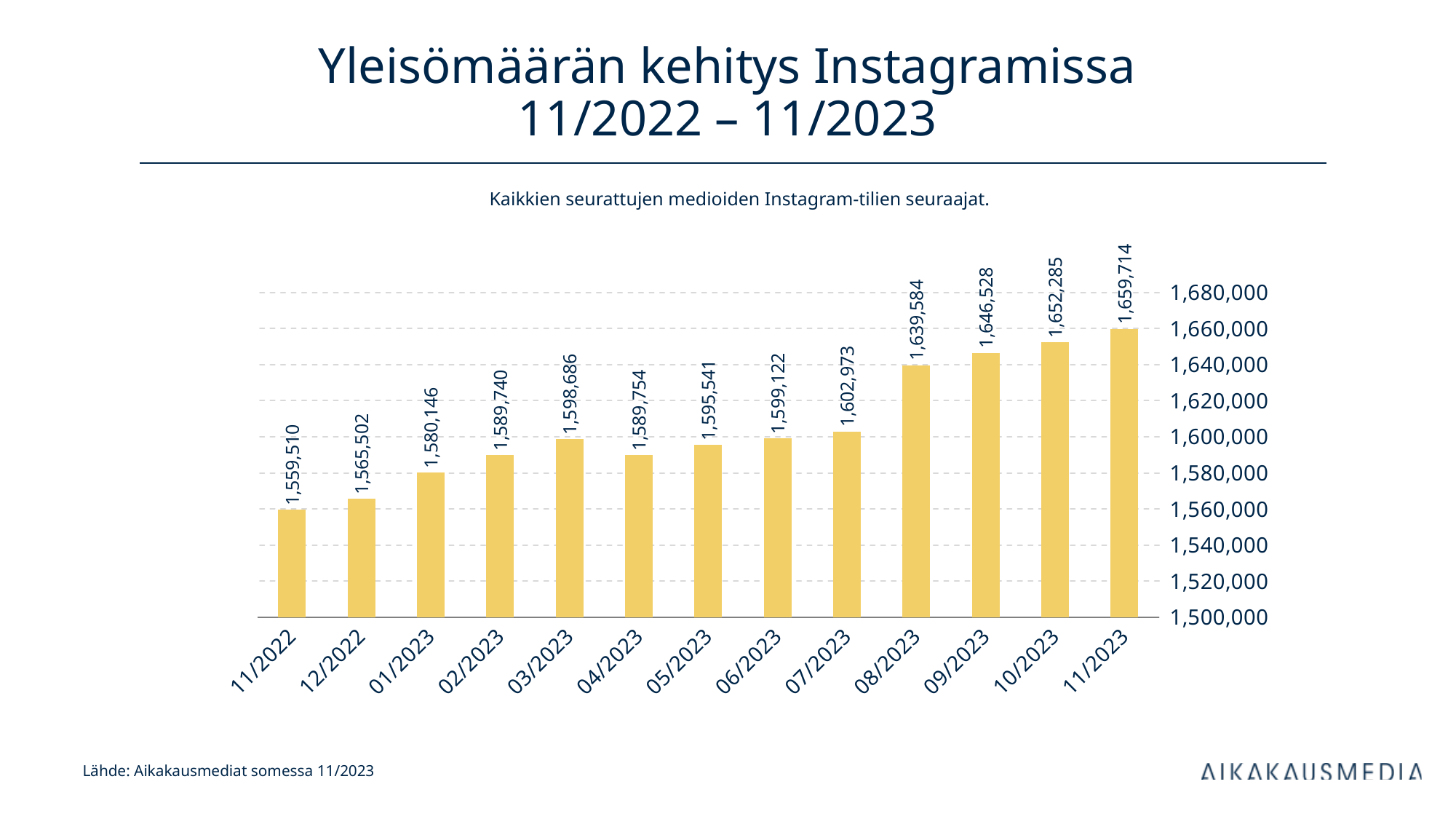
What is the value for 08/2023? 1,639,584 What is the value for 04/2023? 1,589,754 What is the value for 11/2022? 1,559,510 What is the difference between the values for 08/2023 and 07/2023? 36,611 How many months are shown on the x axis? 13 What is the difference between the values for 11/2023 and 11/2022? 100,204 Is the value for 08/2023 greater or less than 1,620,000? greater Do the values generally rise or fall from 11/2022 to 11/2023? rise Which month has the highest value? 11/2023 Which is larger, the value for 03/2023 or the value for 04/2023? 03/2023 What kind of chart is shown on the slide? bar chart Which month has the lowest value? 11/2022